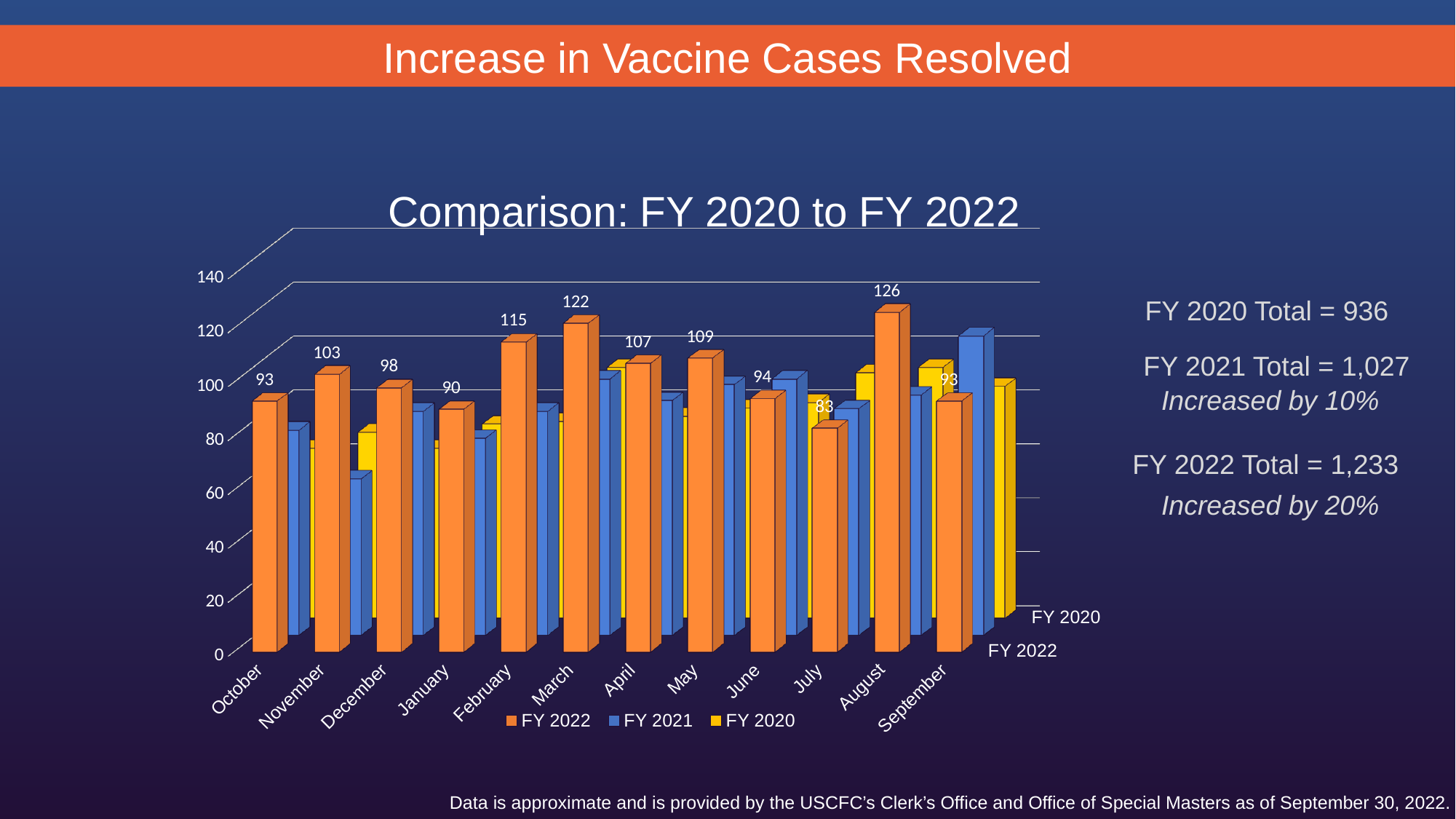
How many months are shown on the x axis? 12 What is the FY 2022 value for February? 115 Which has the larger FY 2022 value, November or December? November Which month has the highest FY 2022 value? August What is the title of the chart? Comparison: FY 2020 to FY 2022 What kind of chart is shown on the slide? Bar chart How many series does the legend list? 3 What is the FY 2022 value for March? 122 What is the FY 2022 value for October? 93 Do the FY 2022 values rise or fall from June to July? Fall What is the difference between the FY 2022 values for August and July? 43 Which month has the lowest FY 2022 value? July